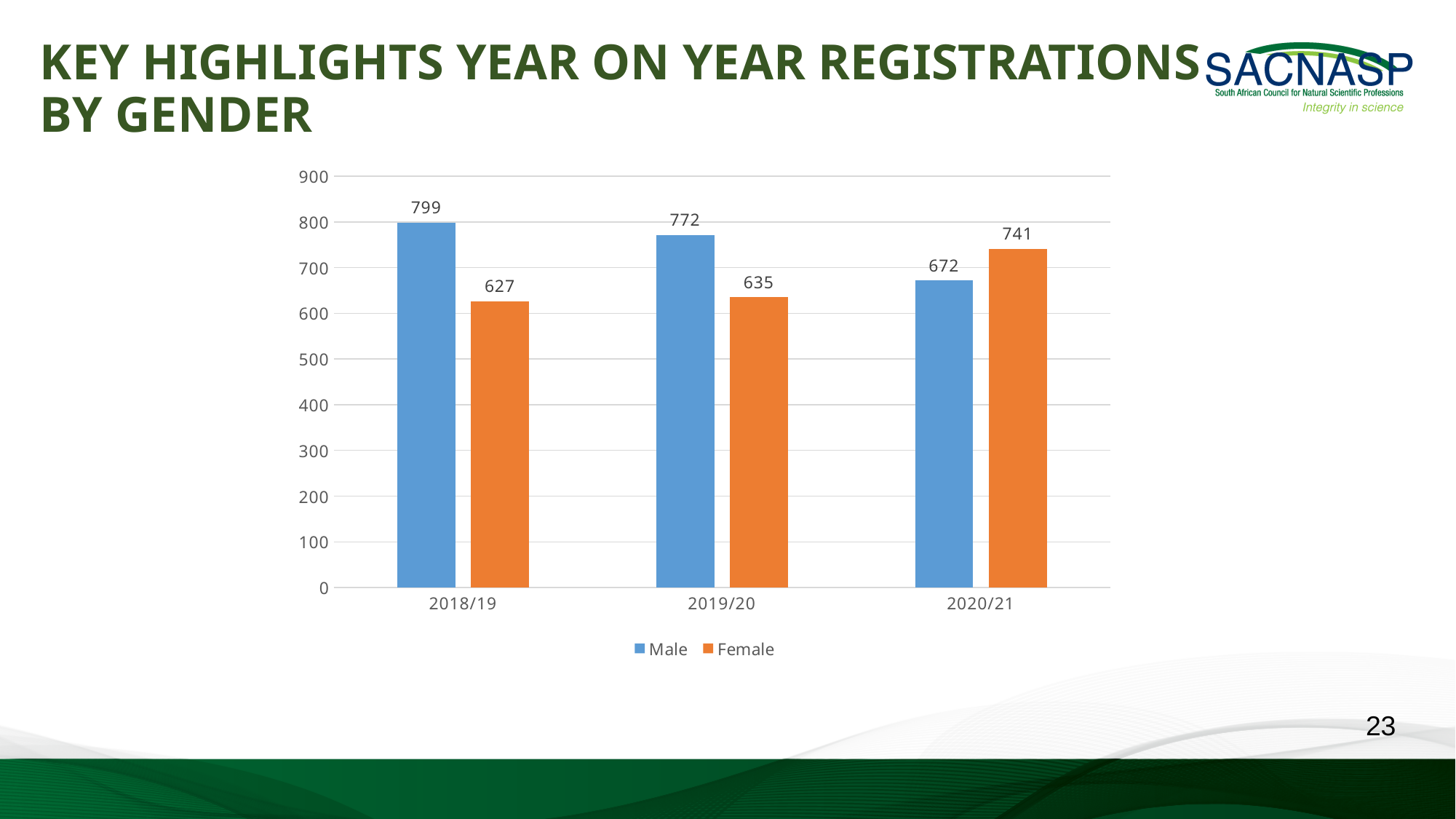
What is the difference between the Male and Female values in 2018/19? 172 What is the Female value for 2019/20? 635 Which year has the lowest Female value? 2018/19 How many years are shown on the x axis? 3 What kind of chart is shown on the slide? Bar chart What is the Male value for 2018/19? 799 How many series does the legend list? 2 Which year has the highest Male value? 2018/19 What is the Female value for 2020/21? 741 Do the Male values rise or fall from 2018/19 to 2020/21? Fall Is the Male value for 2019/20 greater or less than 700? greater In 2020/21, which is larger, the Male or the Female value? Female